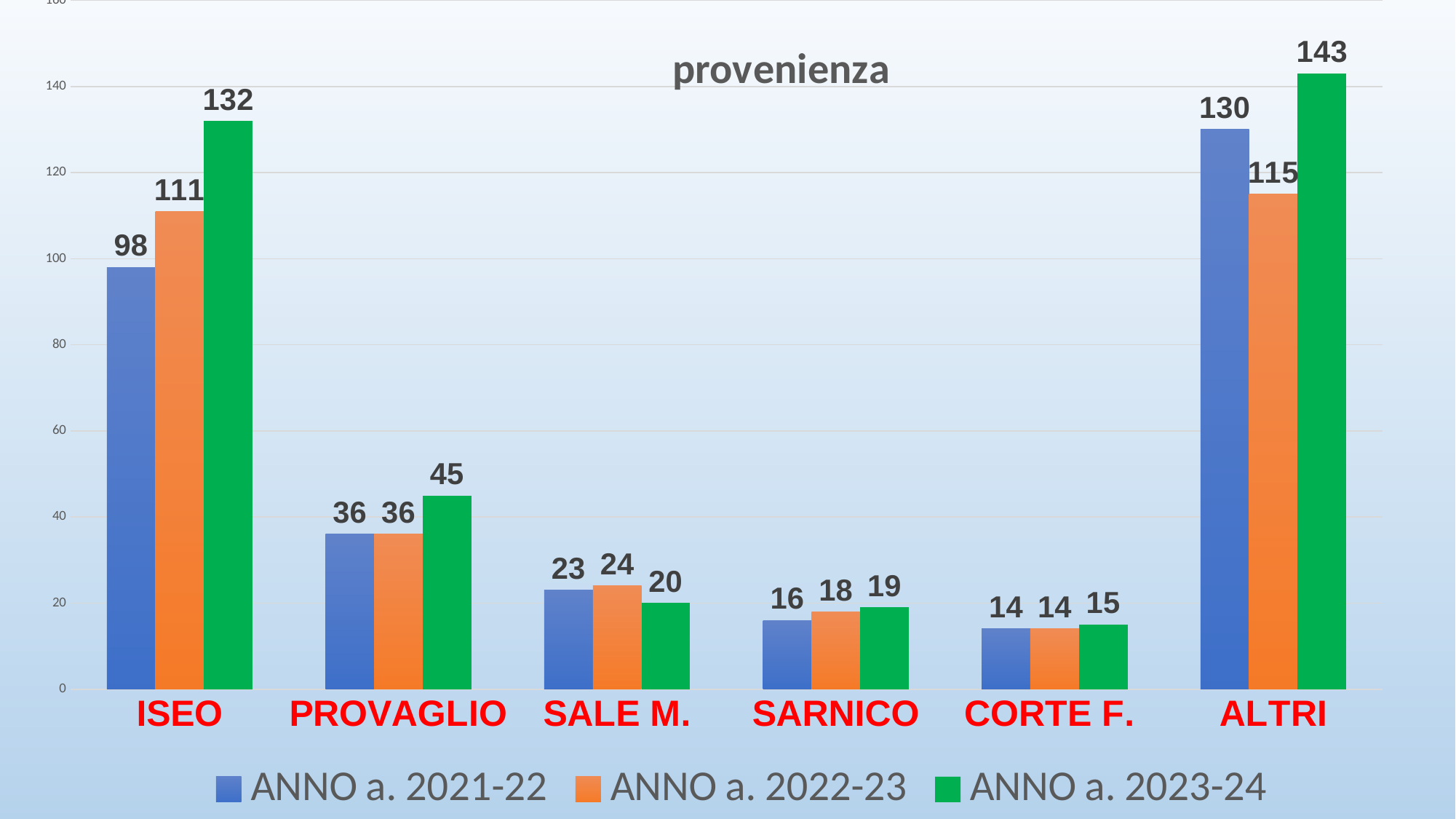
What is the value for ISEO in the ANNO a. 2023-24 series? 132 What is the title of the chart? provenienza How many categories are shown on the x axis? 6 What is the difference between the ANNO a. 2023-24 and ANNO a. 2021-22 values for ISEO? 34 What is the value for ALTRI in the ANNO a. 2022-23 series? 115 For SALE M., which is larger: the ANNO a. 2022-23 value or the ANNO a. 2023-24 value? ANNO a. 2022-23 Which category has the lowest value in the ANNO a. 2021-22 series? CORTE F. What colour are the bars for the ANNO a. 2023-24 series? green What is the value for PROVAGLIO in the ANNO a. 2021-22 series? 36 What kind of chart is shown on the slide? bar chart How many series does the legend list? 3 Which category has the highest value in the ANNO a. 2023-24 series? ALTRI